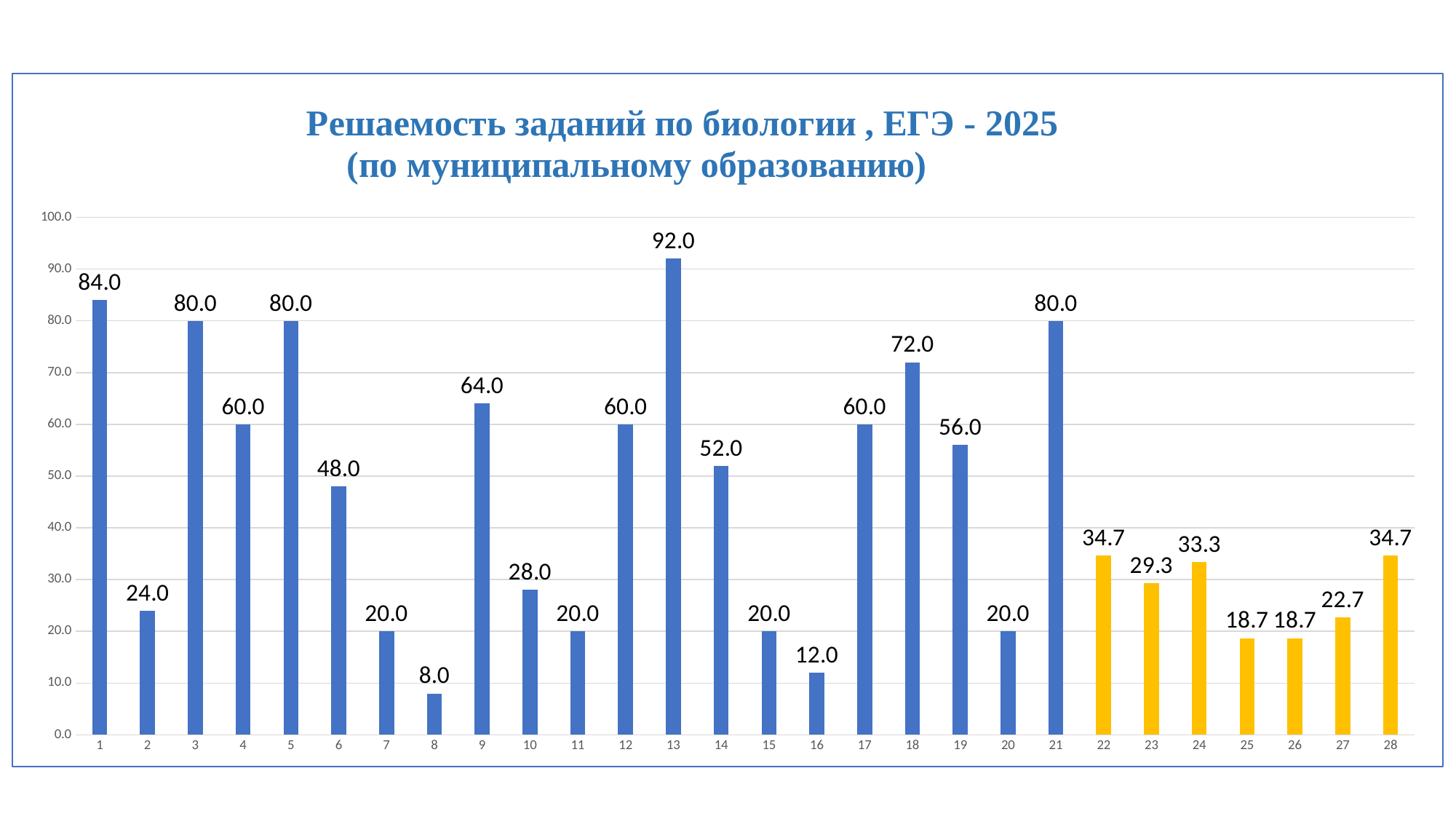
Which task has the highest value? 13 Which is larger, the value for task 23 or the value for task 24? 24 What is the difference between the values for task 18 and task 19? 16.0 How many tasks are shown on the x axis? 28 What kind of chart is shown on the slide? bar chart What is the value for task 22? 34.7 What is the value for task 8? 8.0 Which task has the lowest value? 8 What is the difference between the values for task 13 and task 1? 8.0 Is the value for task 6 greater or less than 40.0? greater What is the value for task 13? 92.0 What colour are the bars for tasks 22 to 28? yellow